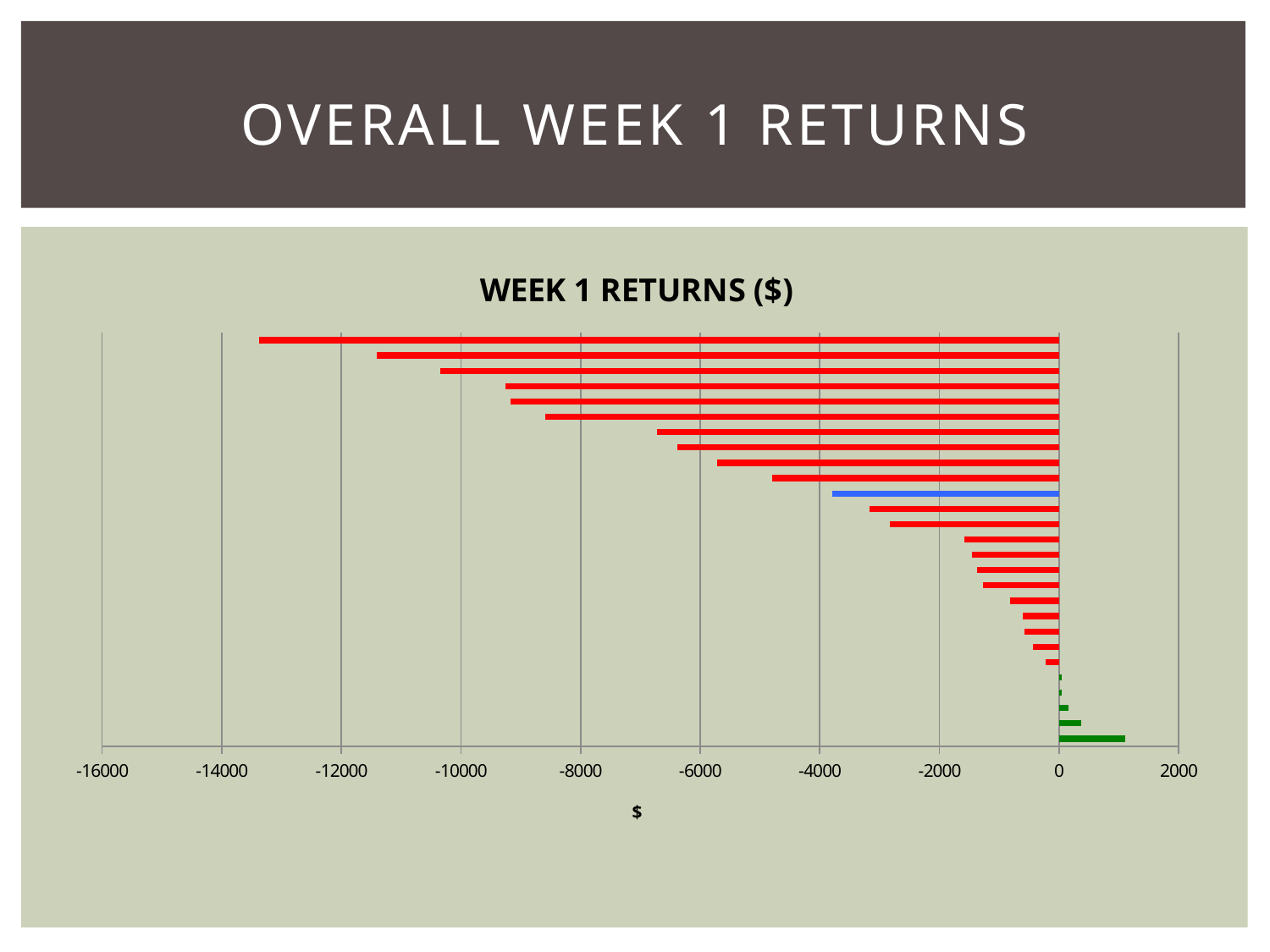
Which bar has the lowest (most negative) value: the top red bar or the blue bar? the top red bar Is the value of the longest green bar (the bottom bar) greater or less than 2000? less What kind of chart is shown on the slide? bar chart Is the value of the second bar from the top greater or less than -10000? less Which bar represents the highest value on the chart? the bottom green bar Which bar represents the lowest value on the chart? the top red bar Is the value of the longest red bar (the top bar) greater or less than -12000? less What is the title of the chart? WEEK 1 RETURNS ($) Do the bar values rise or fall going from the top of the chart to the bottom? rise What is the label on the horizontal axis of the chart? $